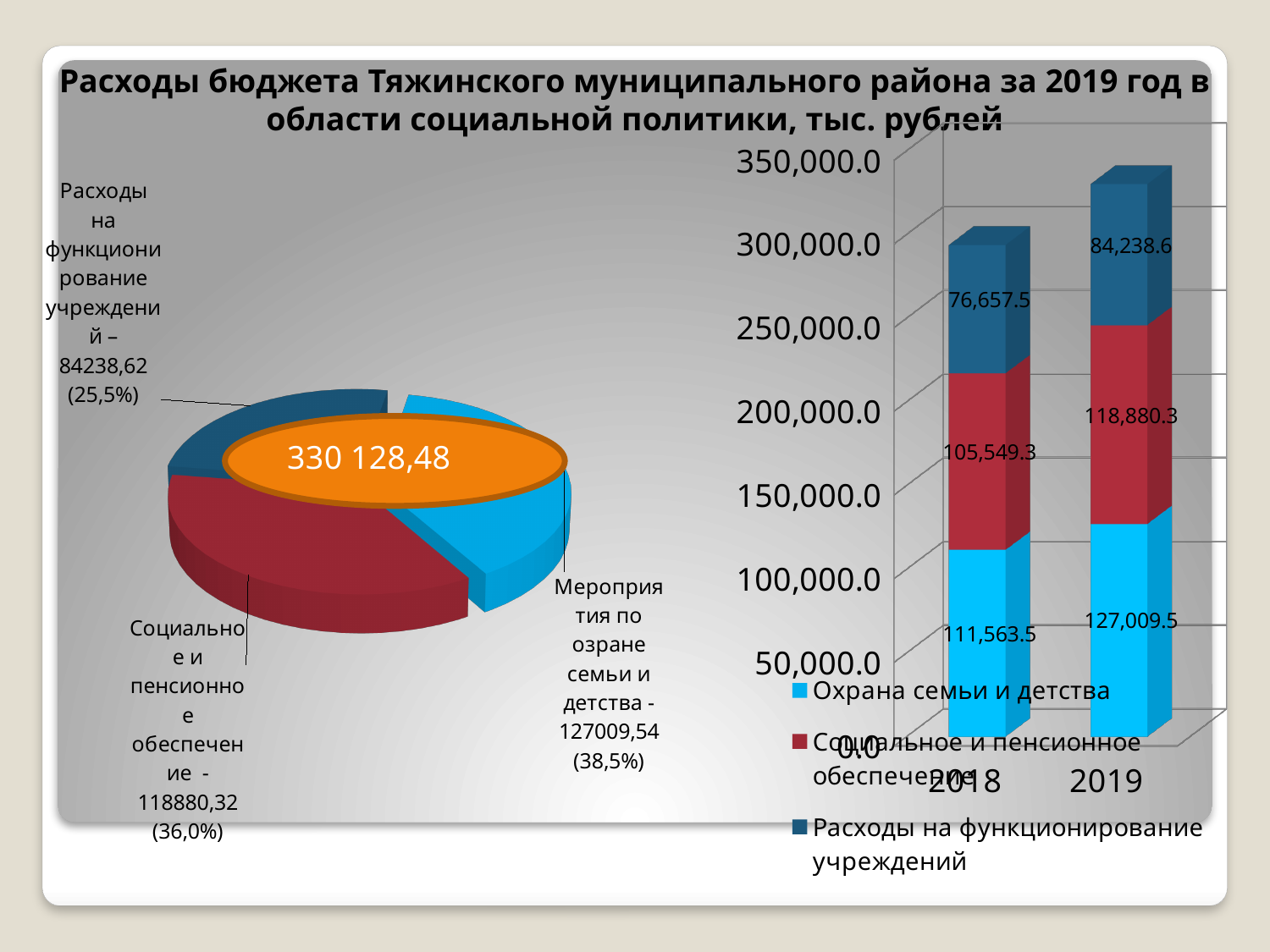
In the bar chart on the right, what is the total of the stacked bar for 2018? 293,770.3 In the bar chart on the right, is the 'Социальное и пенсионное обеспечение' value larger in 2018 or 2019? 2019 In the bar chart on the right, what is the difference between the 'Охрана семьи и детства' values for 2019 and 2018? 15,446.0 In the pie chart on the left, what value is shown for 'Социальное и пенсионное обеспечение'? 118880,32 In the pie chart on the left, what share does 'Мероприятия по озране семьи и детства' have? 38,5% What type of chart is on the left side of the slide? pie chart In the pie chart on the left, what total is shown in the centre? 330 128,48 In the bar chart on the right, how many series does the legend list? 3 In the bar chart on the right, what is the value of 'Расходы на функционирование учреждений' for 2019? 84,238.6 What type of chart is on the right side of the slide? stacked bar chart In the pie chart on the left, which category has the smallest share? Расходы на функционирование учреждений In the bar chart on the right, what is the value of 'Охрана семьи и детства' for 2018? 111,563.5